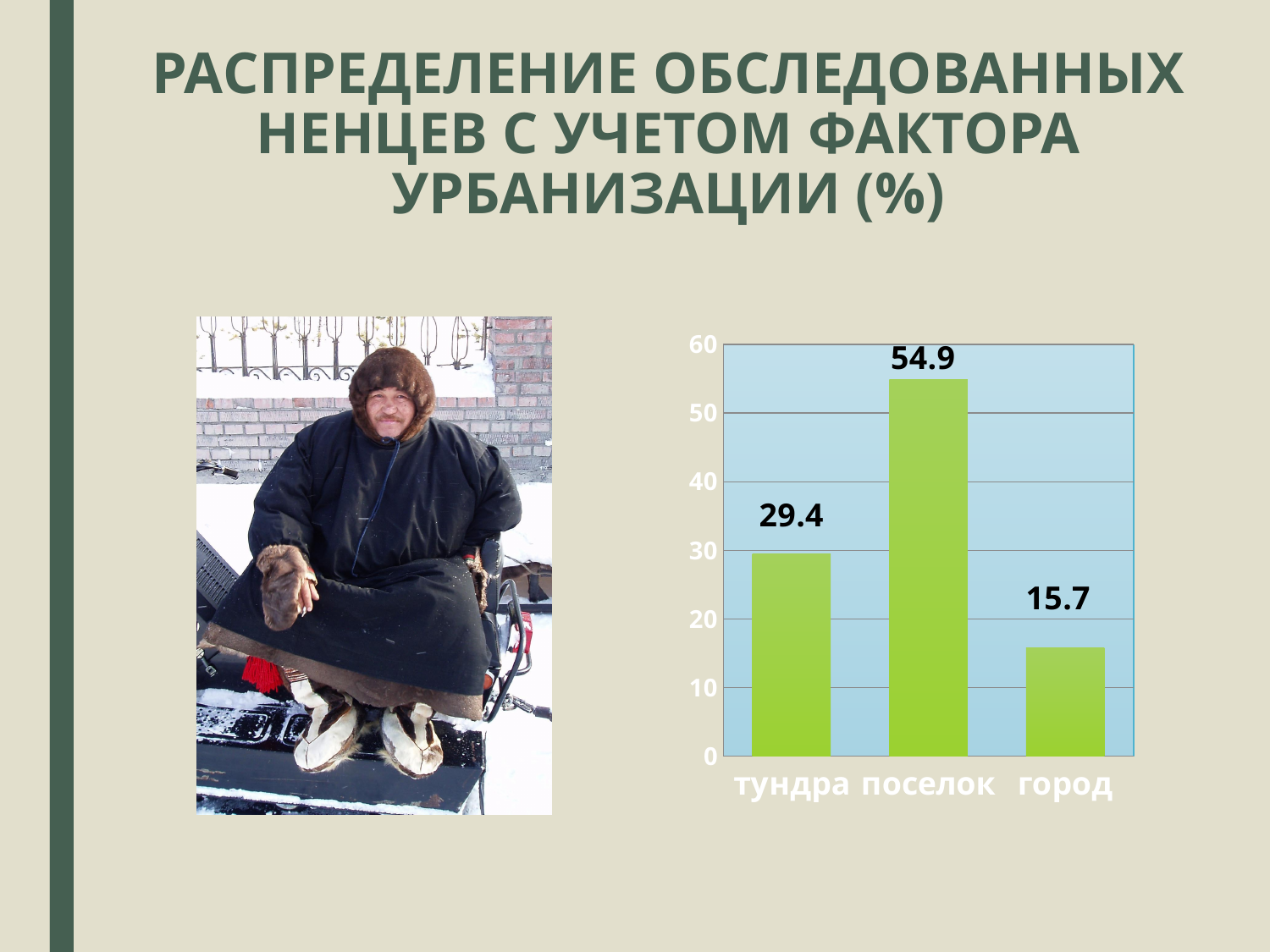
Is the value for поселок greater or less than 50? greater What is the difference between the values for поселок and тундра? 25.5 Which category has the highest value? поселок Which is larger, the value for тундра or the value for город? тундра What is the difference between the values for тундра and город? 13.7 How many categories are shown on the x axis? 3 What is the value for поселок? 54.9 What kind of chart is shown on the slide? bar chart What is the value for город? 15.7 What is the maximum value shown on the vertical axis? 60 What is the value for тундра? 29.4 Which category has the lowest value? город